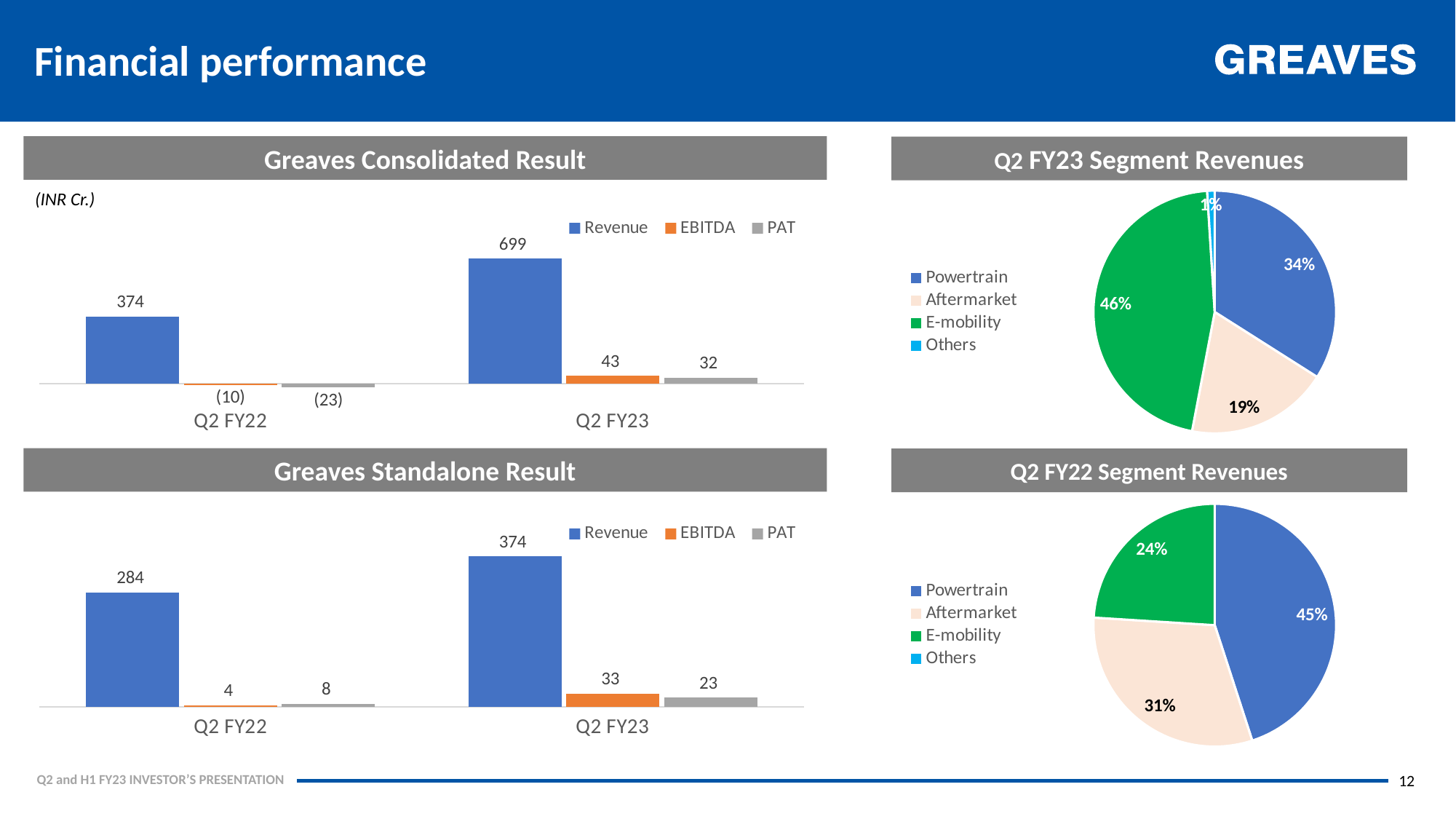
What kind of chart is the Q2 FY22 Segment Revenues chart? pie chart In the Q2 FY23 Segment Revenues chart, which segment has the largest share? E-mobility In the Greaves Consolidated Result chart, how many series does the legend list? 3 In the Greaves Consolidated Result chart, what is the Revenue for Q2 FY23? 699 In the Greaves Consolidated Result chart, what is the PAT value for Q2 FY22? (23) In the Greaves Standalone Result chart, which is larger for Q2 FY23: EBITDA or PAT? EBITDA In the Q2 FY22 Segment Revenues chart, what share does Aftermarket have? 31% In the Greaves Consolidated Result chart, by how much did Revenue increase from Q2 FY22 to Q2 FY23? 325 In the Greaves Standalone Result chart, does Revenue rise or fall from Q2 FY22 to Q2 FY23? rise In the Q2 FY23 Segment Revenues chart, what share does E-mobility have? 46% In the Greaves Standalone Result chart, what is the EBITDA for Q2 FY22? 4 In the Greaves Standalone Result chart, what is the difference between Revenue in Q2 FY23 and Q2 FY22? 90